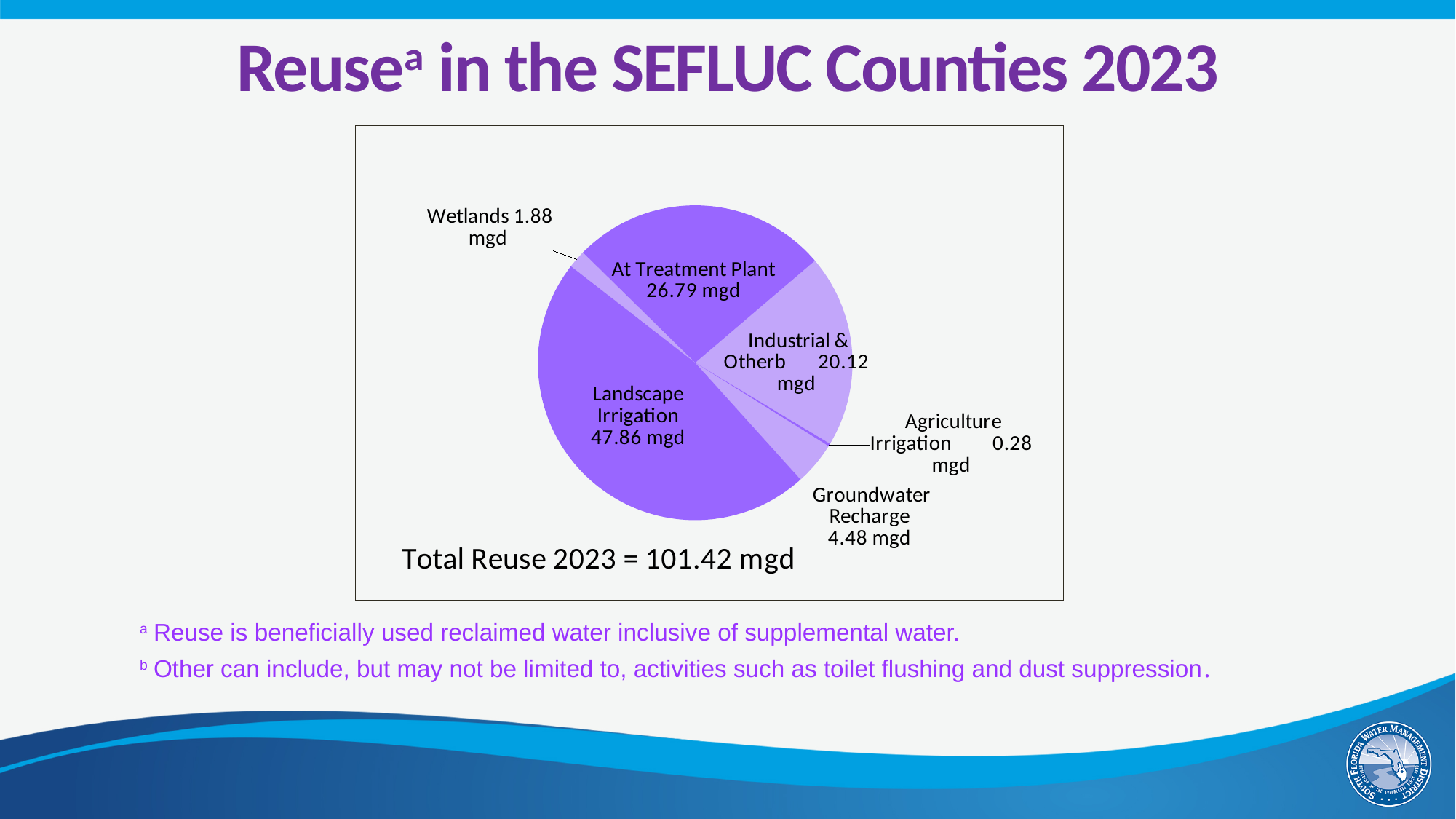
What is the value for Agriculture Irrigation? 0.28 mgd What is the difference between Groundwater Recharge and Wetlands? 2.60 mgd Which is larger, At Treatment Plant or Industrial & Other? At Treatment Plant Which category has the smallest slice of the pie? Agriculture Irrigation What is the value for Landscape Irrigation? 47.86 mgd What is the difference between Landscape Irrigation and At Treatment Plant? 21.07 mgd What is the value for At Treatment Plant? 26.79 mgd How many categories are shown in the pie chart? 6 What kind of chart is shown on the slide? Pie chart Which category has the largest slice of the pie? Landscape Irrigation What is the total reuse for 2023 stated on the chart? 101.42 mgd What is the value for Groundwater Recharge? 4.48 mgd